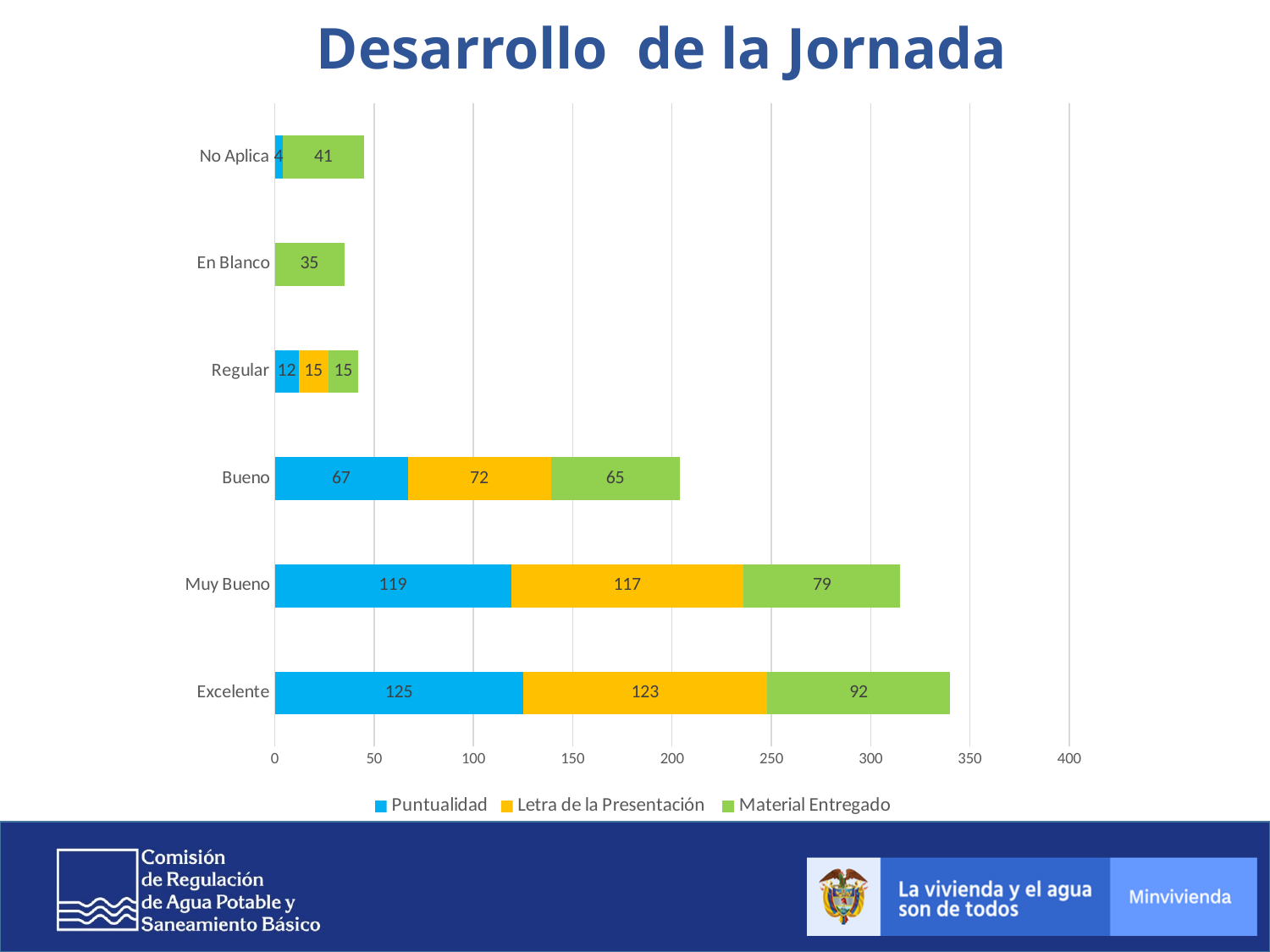
Which category has the lowest Material Entregado value? Regular Which category has the highest Puntualidad value? Excelente What is the title of the chart? Desarrollo de la Jornada What is the difference between the Puntualidad values for Excelente and Muy Bueno? 6 What is the total of the stacked bar for Bueno? 204 What is the Puntualidad value for Excelente? 125 What is the Letra de la Presentación value for Muy Bueno? 117 Which is larger for Bueno: Letra de la Presentación or Material Entregado? Letra de la Presentación What type of chart is shown on the slide? Stacked bar chart What is the Material Entregado value for En Blanco? 35 How many series does the legend list? 3 How many categories are shown on the chart? 6